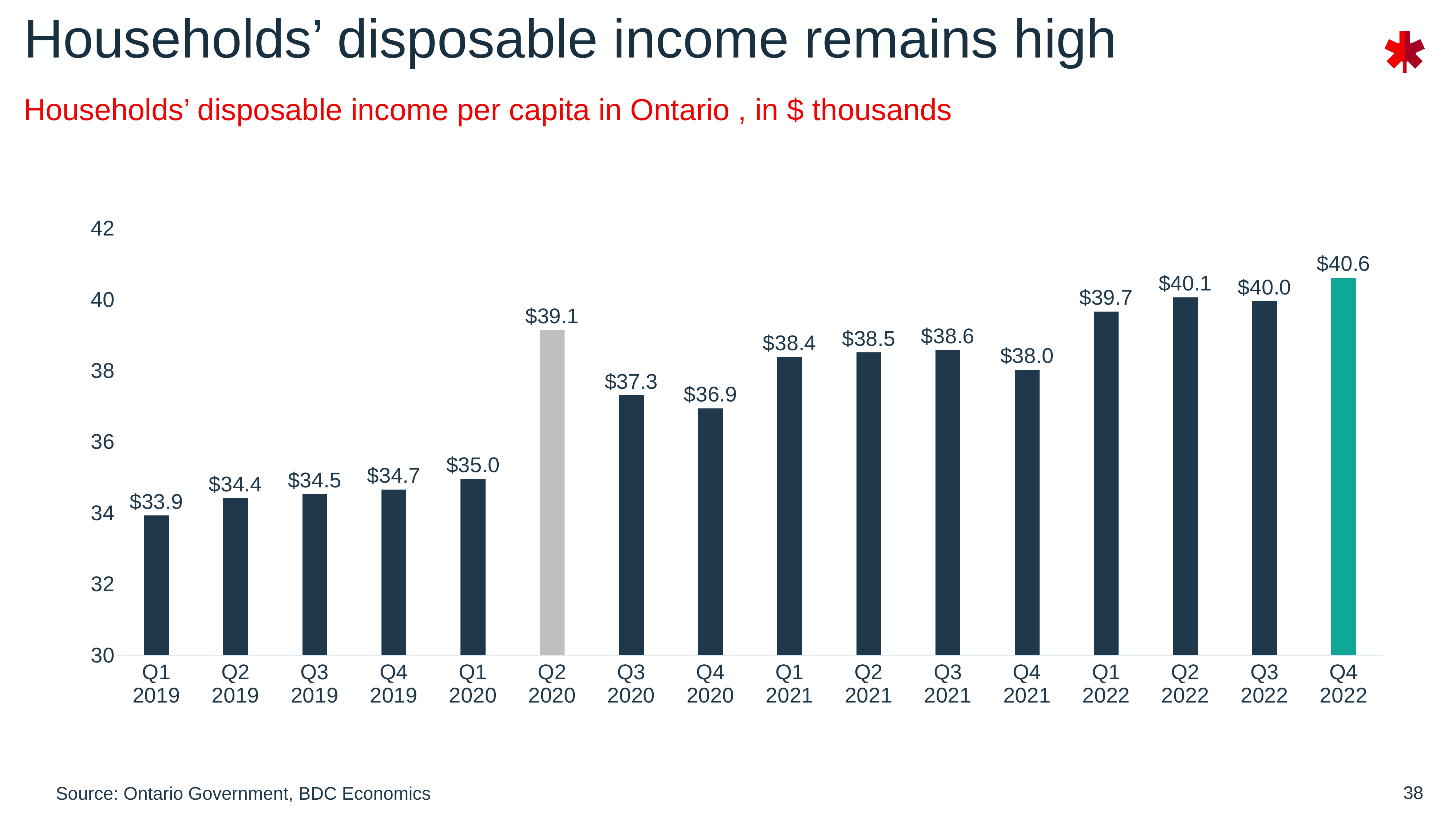
Which quarter has the highest disposable income per capita? Q4 2022 What is the households' disposable income per capita for Q2 2020? $39.1 Which quarter's bar is coloured grey? Q2 2020 How many quarters are shown on the chart? 16 Do the values generally rise or fall from Q1 2019 to Q4 2022? Rise What is the value shown for Q1 2019? $33.9 Which is larger, the value for Q2 2022 or the value for Q3 2022? Q2 2022 What is the difference between the values for Q4 2022 and Q1 2019? $6.7 What type of chart is shown on the slide? Bar chart What is the difference between the values for Q2 2020 and Q3 2020? $1.8 What is the value shown for Q4 2022? $40.6 Which quarter has the lowest disposable income per capita? Q1 2019